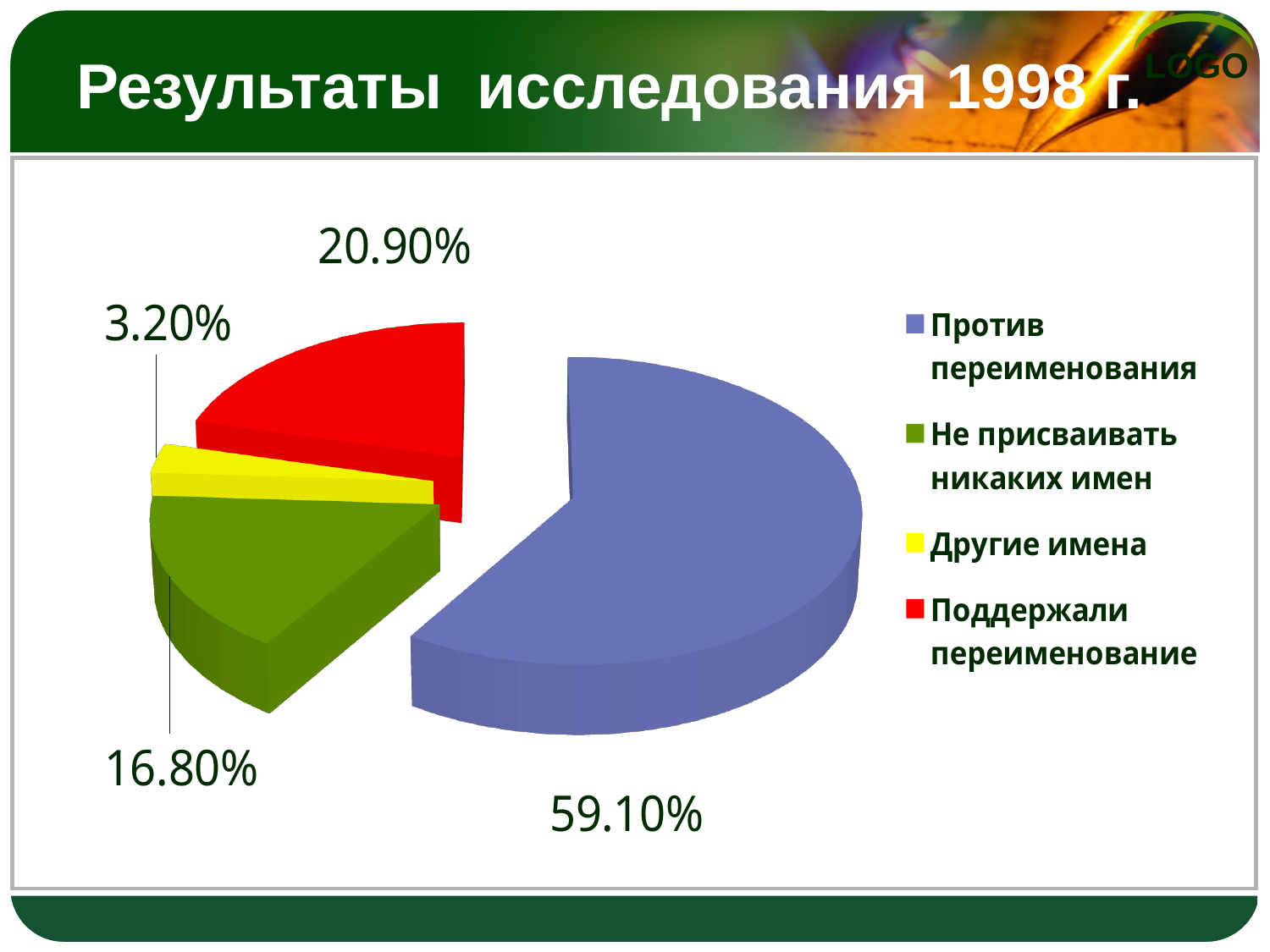
What share of the pie is labelled for "Другие имена"? 3.20% What colour is the slice for "Другие имена"? yellow Which category has the smallest slice of the pie? Другие имена What share of the pie is labelled for "Поддержали переименование"? 20.90% What kind of chart is shown on the slide? pie chart Which is larger: the slice for "Поддержали переименование" or the slice for "Не присваивать никаких имен"? Поддержали переименование What is the title of the slide containing the chart? Результаты исследования 1998 г. How many slices does the pie chart have? 4 What share of the pie is labelled for "Против переименования"? 59.10% Which category has the largest slice of the pie? Против переименования What is the difference in percentage points between "Против переименования" and "Поддержали переименование"? 38.20% What share of the pie is labelled for "Не присваивать никаких имен"? 16.80%